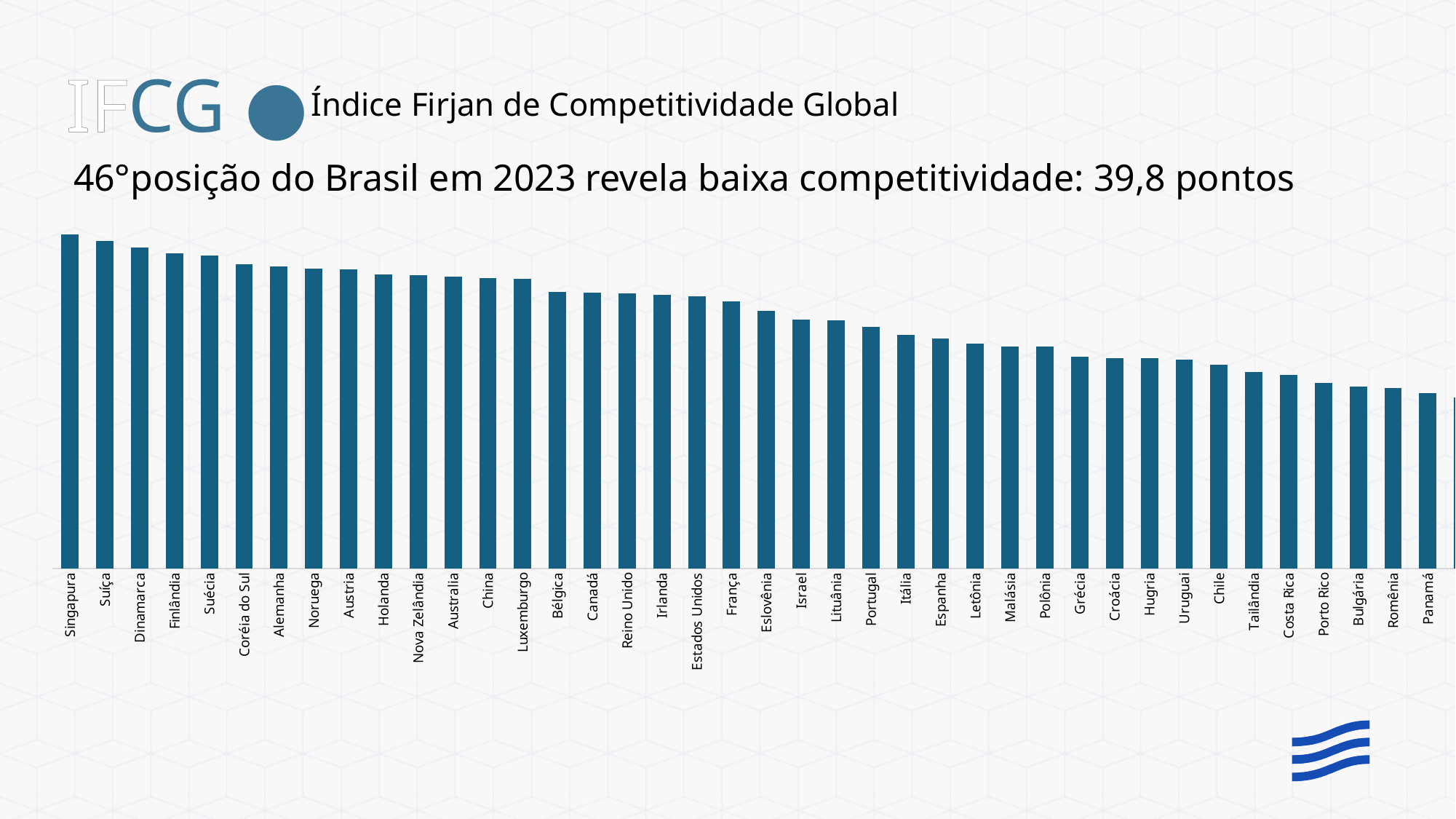
Do the bar values rise or fall from left to right across the chart? fall What kind of chart is shown on the slide? bar chart What is the title text shown above the chart? 46°posição do Brasil em 2023 revela baixa competitividade: 39,8 pontos Which country has the highest bar in the chart? Singapura Which has the larger value, Luxemburgo or Portugal? Luxemburgo Which has the larger value, Uruguai or Estados Unidos? Estados Unidos Which has the larger value, Romênia or Alemanha? Alemanha Which country is the leftmost category on the x axis? Singapura